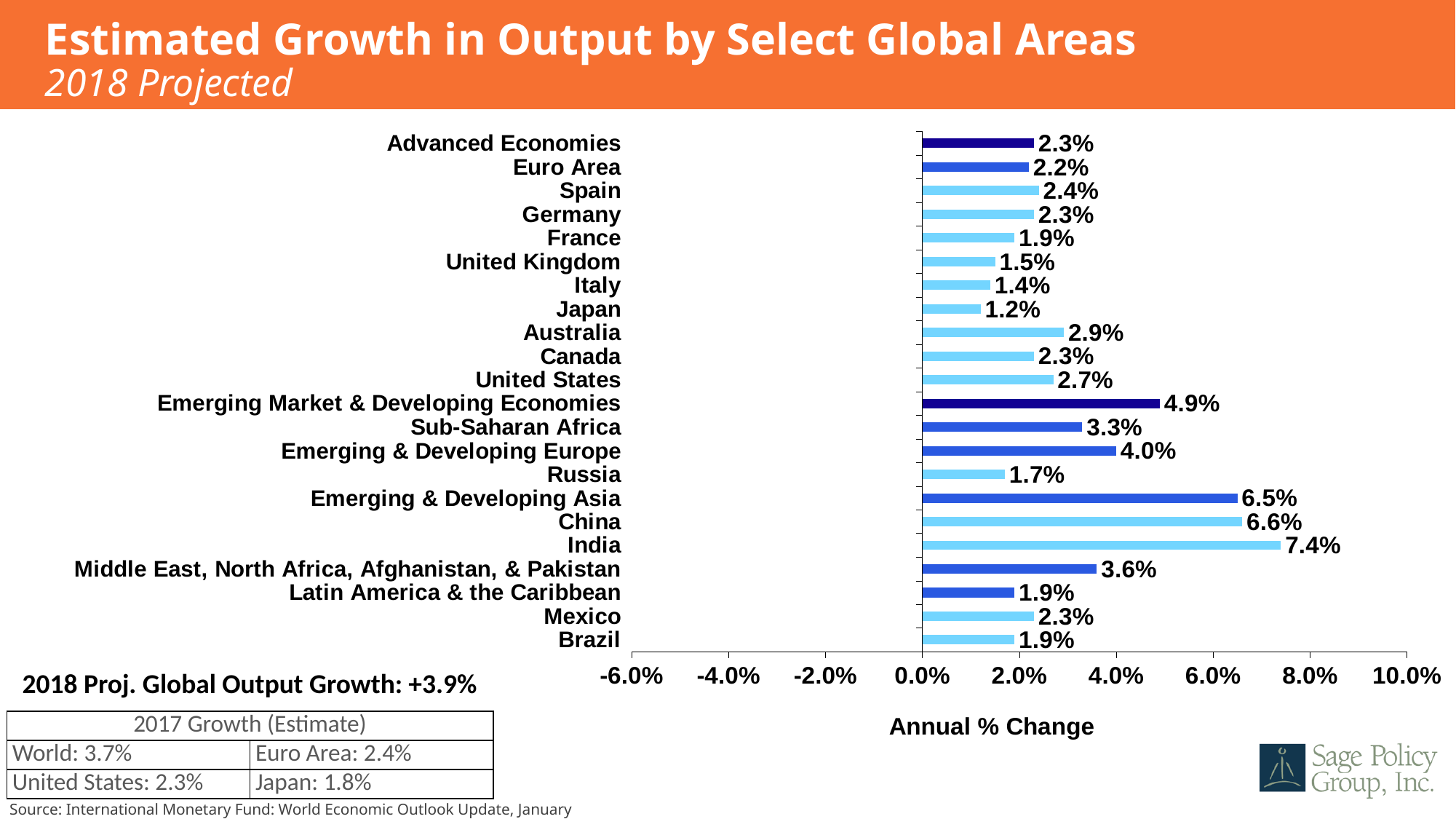
Which has a higher projected 2018 growth: Sub-Saharan Africa or Emerging & Developing Europe? Emerging & Developing Europe Which area has the highest projected 2018 growth in output? India How many areas are plotted in the chart? 22 What is the difference between the projected growth for China and for Russia? 4.9% What is the projected 2018 growth in output for Emerging Market & Developing Economies? 4.9% What is the projected 2018 growth in output for India? 7.4% What kind of chart is shown on the slide? Bar chart Which area has the lowest projected 2018 growth in output? Japan What is the projected 2018 growth in output for the United States? 2.7% Is the projected growth for Emerging & Developing Asia greater or less than 6.0%? greater What is the projected 2018 growth in output for Japan? 1.2% What is the label of the horizontal axis? Annual % Change